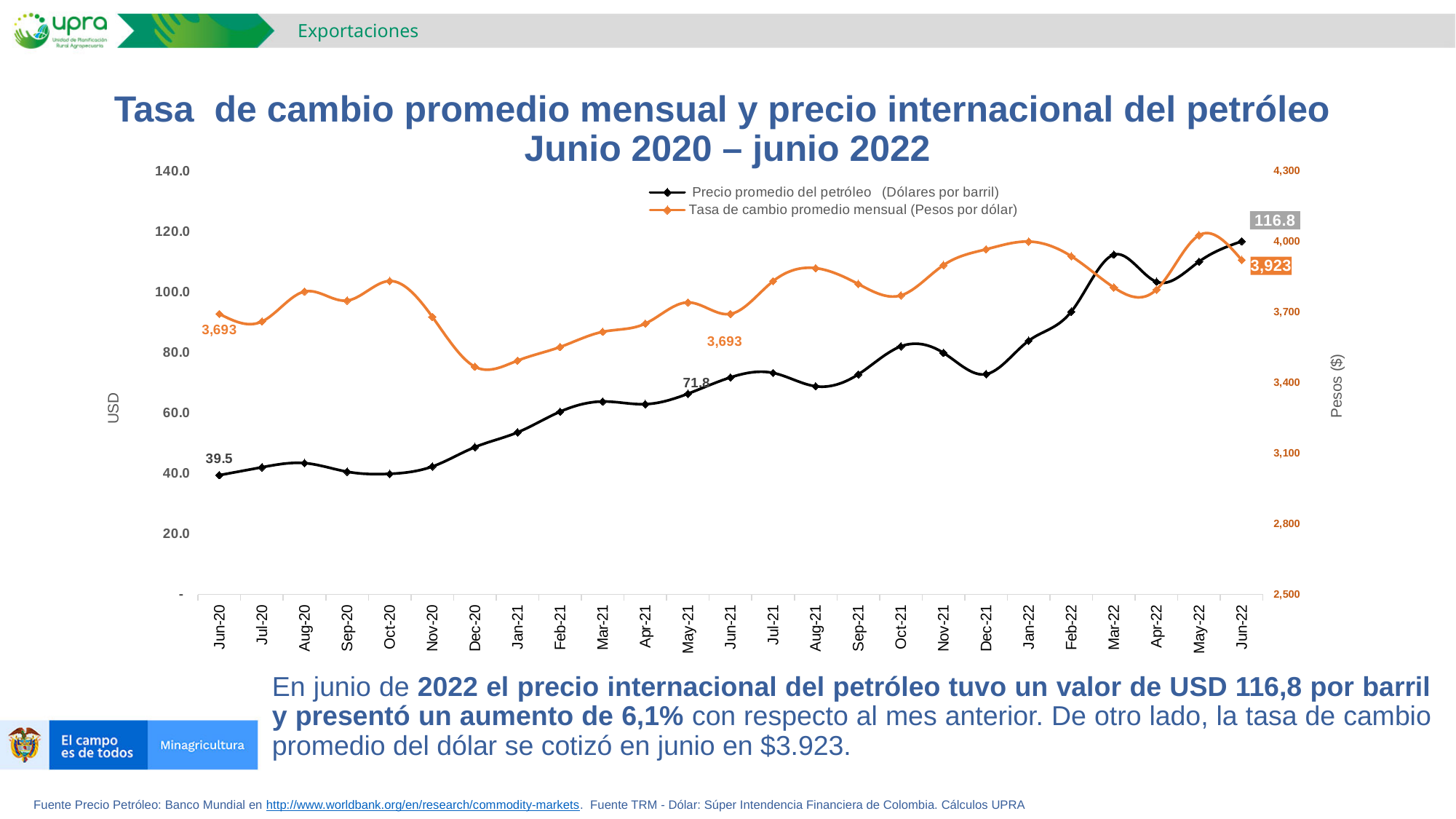
Is the average oil price in Mar-22 greater or less than 100.0? greater In which month does the exchange rate series reach its lowest value? Dec-20 In which month does the average oil price series reach its highest value? Jun-22 What was the average oil price (Precio promedio del petróleo) in Jun-20? 39.5 By how much did the average oil price increase from Jun-20 to Jun-22? 77.3 How many series does the legend list? 2 What is the difference between the exchange rate in Jun-22 and in Jun-20? 230 What type of chart is shown on the slide? Line chart How many months are plotted along the x axis? 25 What was the average oil price (Precio promedio del petróleo) in Jun-22? 116.8 What was the monthly average exchange rate (Tasa de cambio promedio mensual) in Jun-22? 3,923 What was the monthly average exchange rate (Tasa de cambio promedio mensual) in Jun-20? 3,693